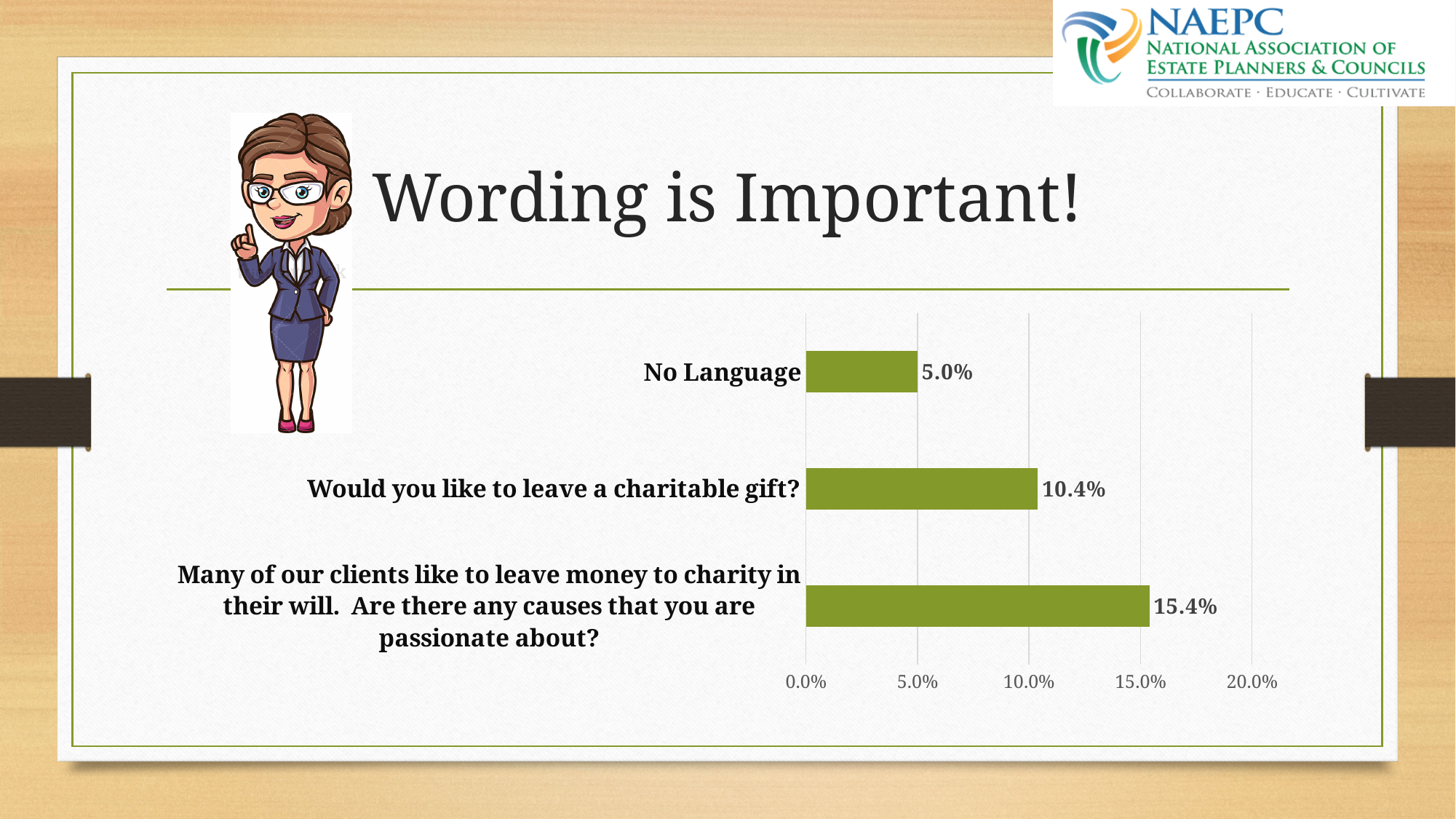
What is the title of the slide containing the chart? Wording is Important! Which is larger: the value for "No Language" or the value for "Would you like to leave a charitable gift?"? Would you like to leave a charitable gift? What is the difference between the value for "Would you like to leave a charitable gift?" and the value for "No Language"? 5.4% Which category has the highest value? Many of our clients like to leave money to charity in their will. Are there any causes that you are passionate about? What is the value for "Would you like to leave a charitable gift?"? 10.4% What is the difference between the highest and lowest values in the chart? 10.4% What kind of chart is shown on the slide? Bar chart What is the value for the category beginning "Many of our clients like to leave money to charity in their will"? 15.4% How many categories are shown in the chart? 3 Is the value for "Would you like to leave a charitable gift?" greater or less than 10.0%? greater Which category has the lowest value? No Language What is the value for "No Language"? 5.0%